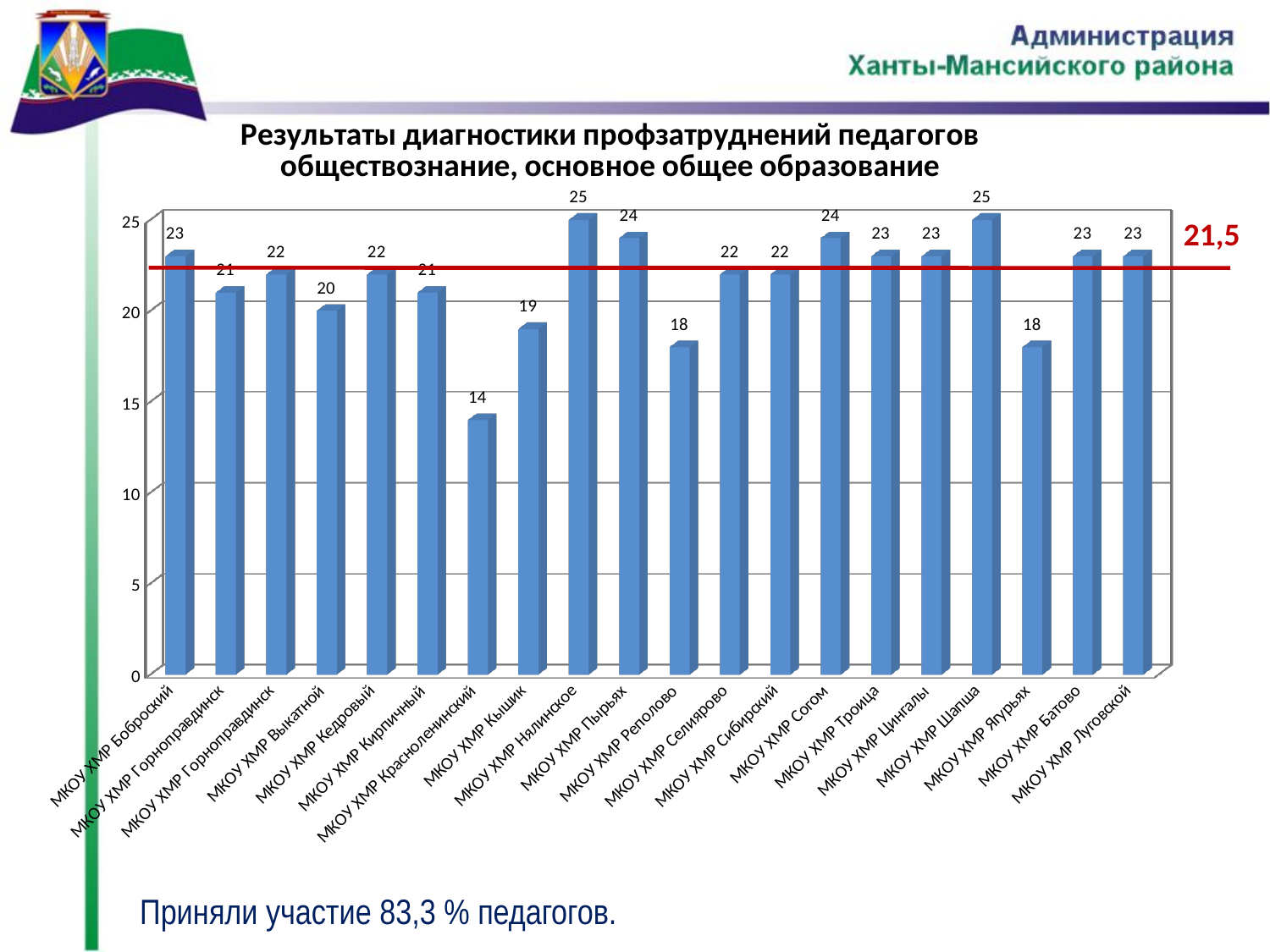
What is the value for МКОУ ХМР Красноленинский? 14 What kind of chart is shown on the slide? bar chart How many bars are shown in the chart? 20 What is the value for МКОУ ХМР Нялинское? 25 What value is marked by the red horizontal line on the chart? 21,5 Which is larger, the value for МКОУ ХМР Пырьях or the value for МКОУ ХМР Кышик? МКОУ ХМР Пырьях What is the difference between the values for МКОУ ХМР Шапша and МКОУ ХМР Ягурьях? 7 What is the difference between the values for МКОУ ХМР Кедровый and МКОУ ХМР Кирпичный? 1 What is the value for МКОУ ХМР Реполово? 18 Which school has the lowest value? МКОУ ХМР Красноленинский Is the value for МКОУ ХМР Согом greater or less than 20? greater What is the value for МКОУ ХМР Выкатной? 20